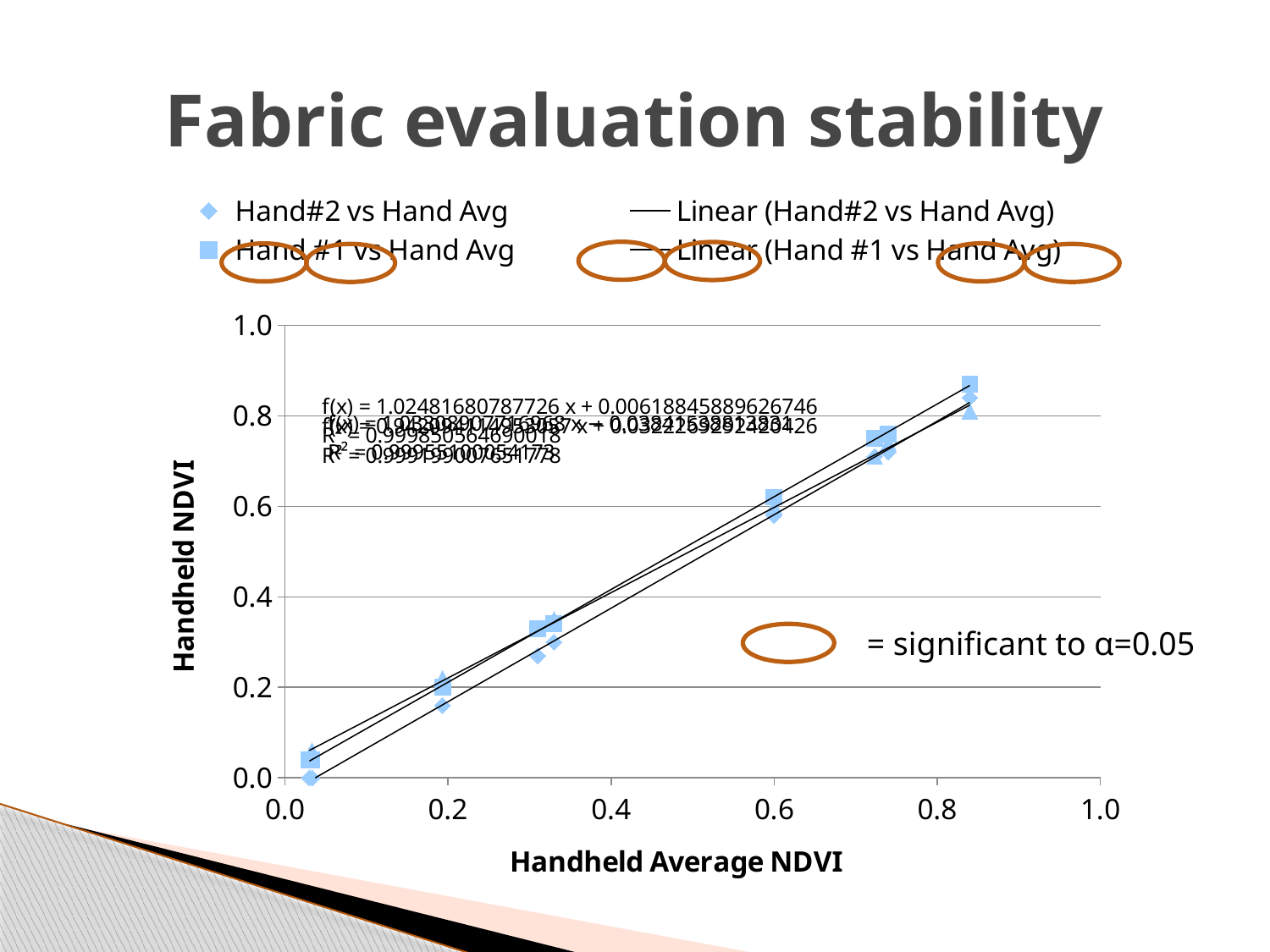
What is the title of the vertical axis of the chart? Handheld NDVI Are the Handheld NDVI values for the points near a Handheld Average NDVI of 0.2 greater or less than 0.4? less Are the Handheld NDVI values for the points near a Handheld Average NDVI of 0.6 greater or less than 0.8? less Which is larger: the Handheld NDVI of the points near a Handheld Average NDVI of 0.84, or the Handheld NDVI of the points near 0.6? The points near 0.84 How many entries does the chart legend list? 4 Are the Handheld NDVI values for the points near a Handheld Average NDVI of 0.74 greater or less than 0.6? greater What is the title of the horizontal axis of the chart? Handheld Average NDVI Do the plotted Handheld NDVI values rise or fall as Handheld Average NDVI increases along the x axis? Rise What kind of chart is shown on the slide? Scatter chart What is the highest value shown on the vertical axis of the chart? 1.0